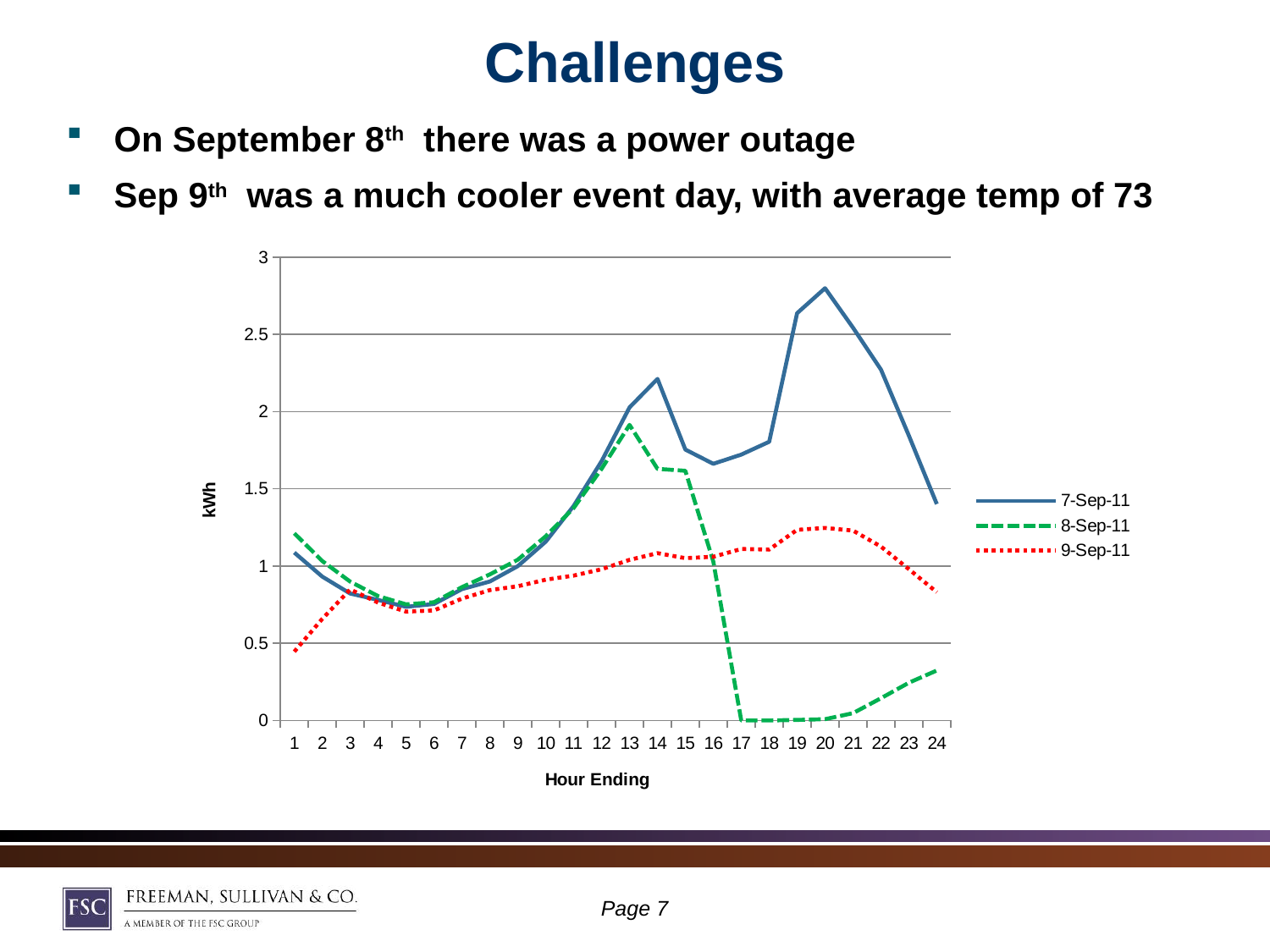
Is the value for 8-Sep-11 at hour ending 18 greater or less than 0.5? less At which hour ending does the 7-Sep-11 series reach its highest value? 20 Does the 7-Sep-11 series rise or fall from hour ending 20 to hour ending 24? fall Which series reaches the highest value on the chart? 7-Sep-11 At hour ending 1, which series has the larger value, 8-Sep-11 or 9-Sep-11? 8-Sep-11 What is the label of the x axis? Hour Ending How many series does the legend list? 3 What kind of chart is shown on the slide? line chart What is the label of the y axis? kWh Which series has the lowest value at hour ending 20? 8-Sep-11 How many hours are plotted along the x axis? 24 Is the value for 7-Sep-11 at hour ending 20 greater or less than 2.5? greater